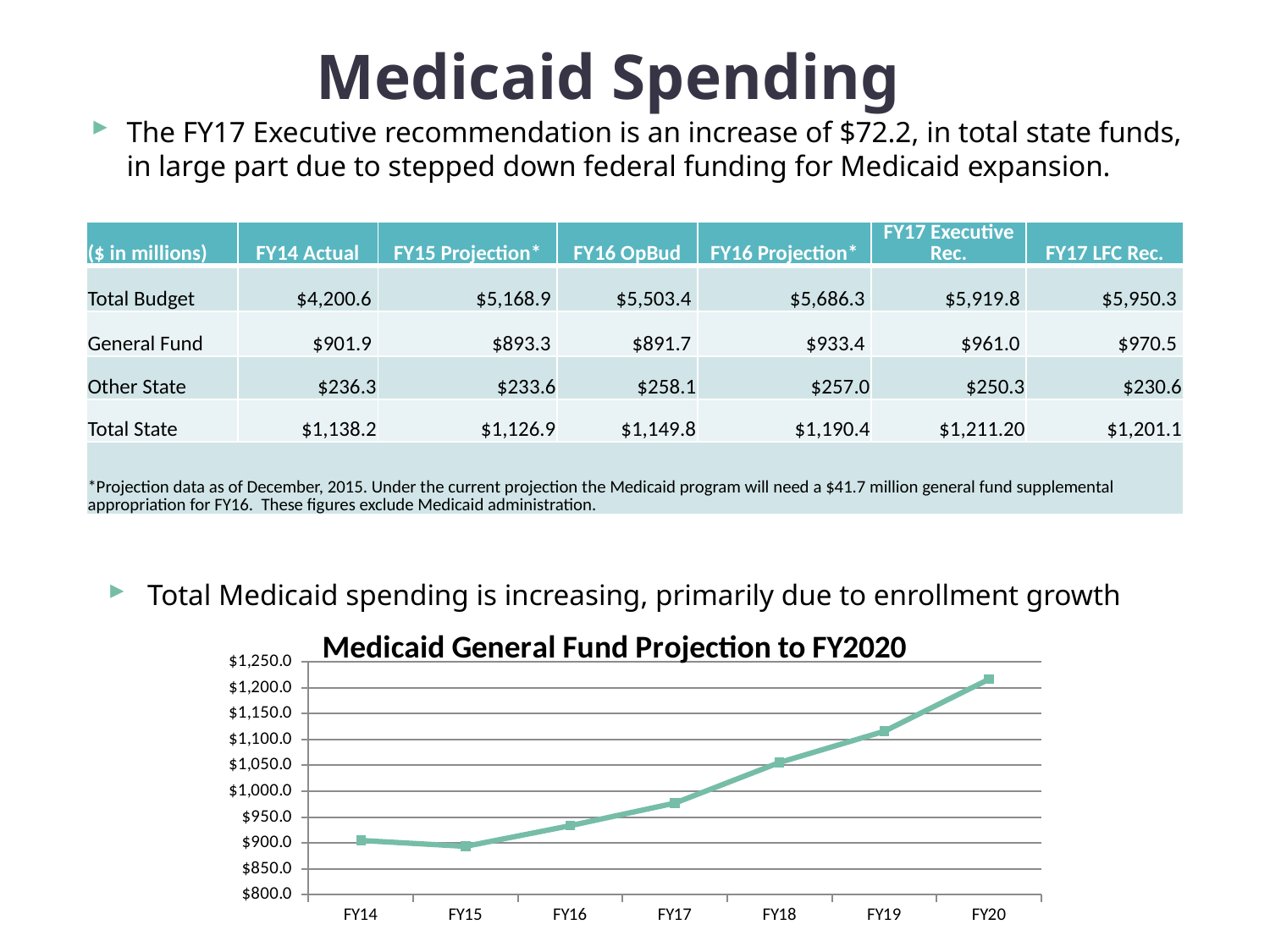
Which is larger, the value for FY20 or the value for FY14? FY20 Is the value for FY19 greater or less than $1,100.0? greater How many fiscal years are plotted on the x axis of the chart? 7 What kind of chart is shown on the slide? line chart Which fiscal year has the lowest value in the chart? FY15 Is the value for FY16 greater or less than $950.0? less Do the values in the chart generally rise or fall from FY15 to FY20? rise Is the value for FY17 greater or less than $1,000.0? less Which fiscal year has the highest value in the chart? FY20 What is the title of the chart on the slide? Medicaid General Fund Projection to FY2020